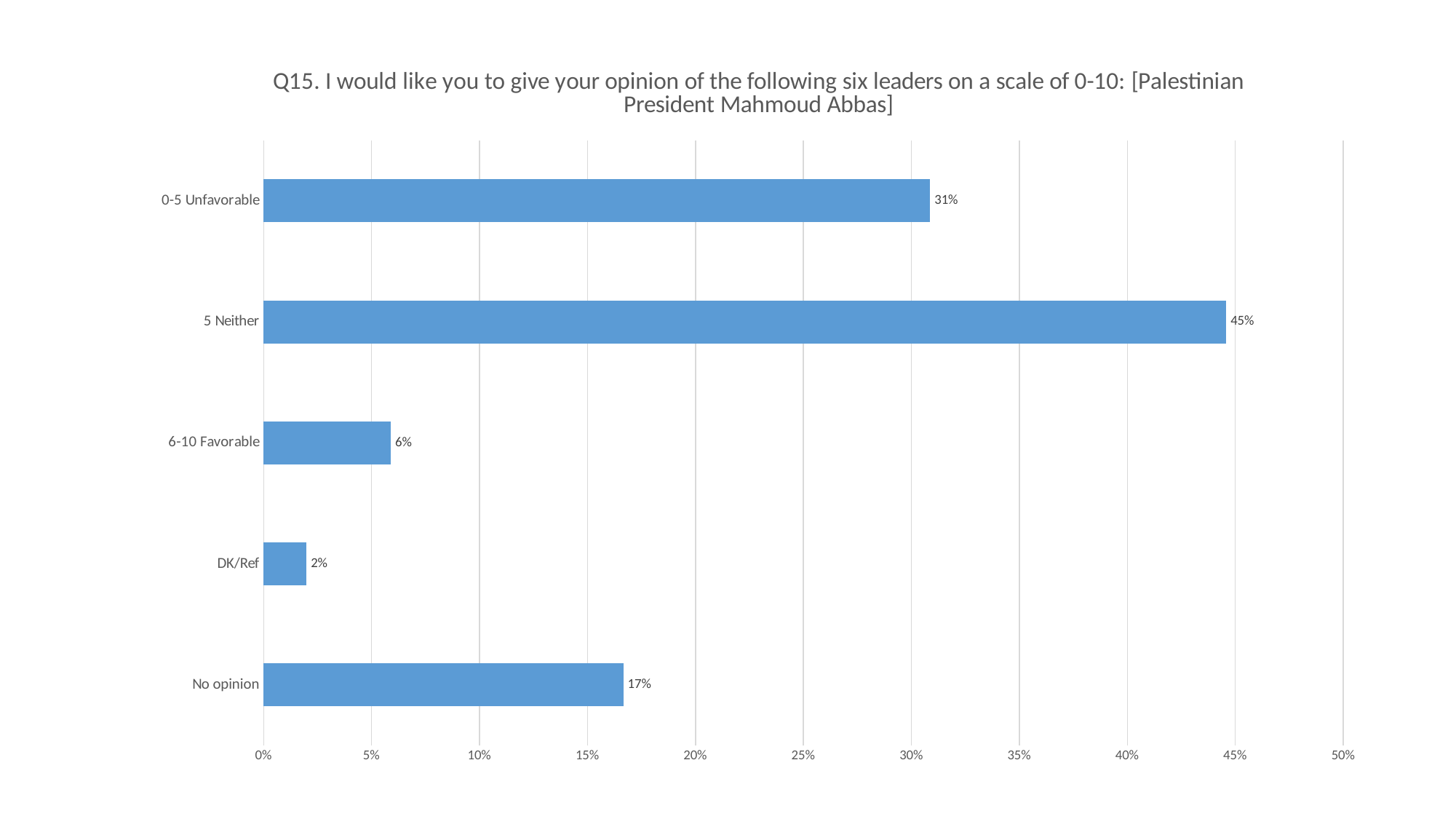
What is the value for 6-10 Favorable? 6% What is the value for DK/Ref? 2% What is the difference between the values for 5 Neither and 0-5 Unfavorable? 14% What is the value for 0-5 Unfavorable? 31% Is the value for 0-5 Unfavorable greater or less than 30%? greater How many categories are shown in the chart? 5 Which is larger, the value for No opinion or the value for 6-10 Favorable? No opinion What is the value for No opinion? 17% What kind of chart is shown on the slide? Bar chart What is the value for 5 Neither? 45% Which category has the lowest value? DK/Ref Which category has the highest value? 5 Neither